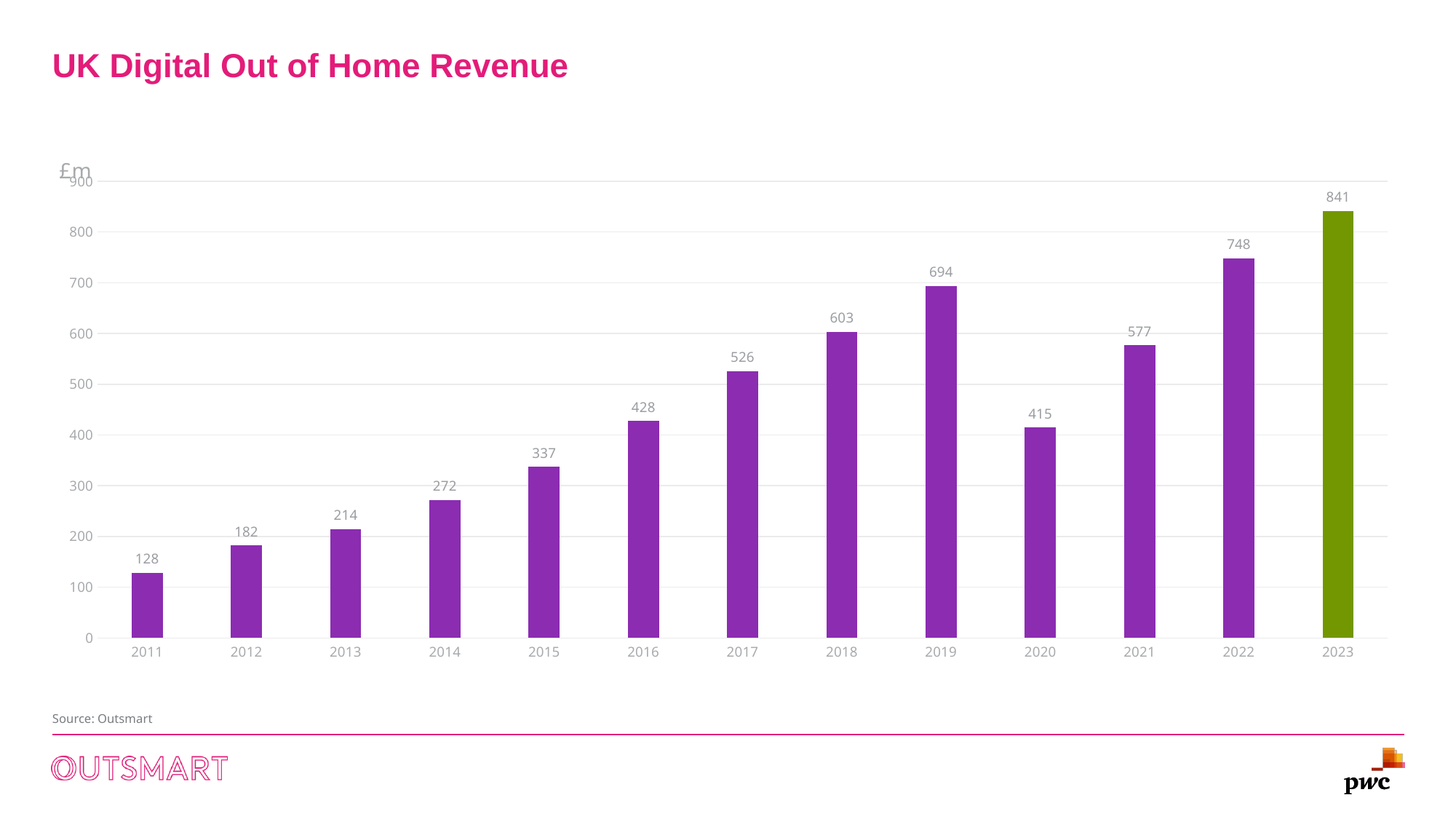
Do the values rise or fall from 2011 to 2019? Rise Which year has the lowest revenue? 2011 What is the UK Digital Out of Home revenue for 2019? 694 What is the difference between the 2023 value and the 2022 value? 93 What is the difference between the 2019 value and the 2020 value? 279 Which year has the highest revenue? 2023 What is the value shown for 2011? 128 Which bar is shown in a different colour (green) from the others? 2023 What is the value shown for 2020? 415 Which is larger, the value for 2018 or the value for 2021? 2018 What kind of chart is this? Bar chart How many years are shown on the x axis? 13